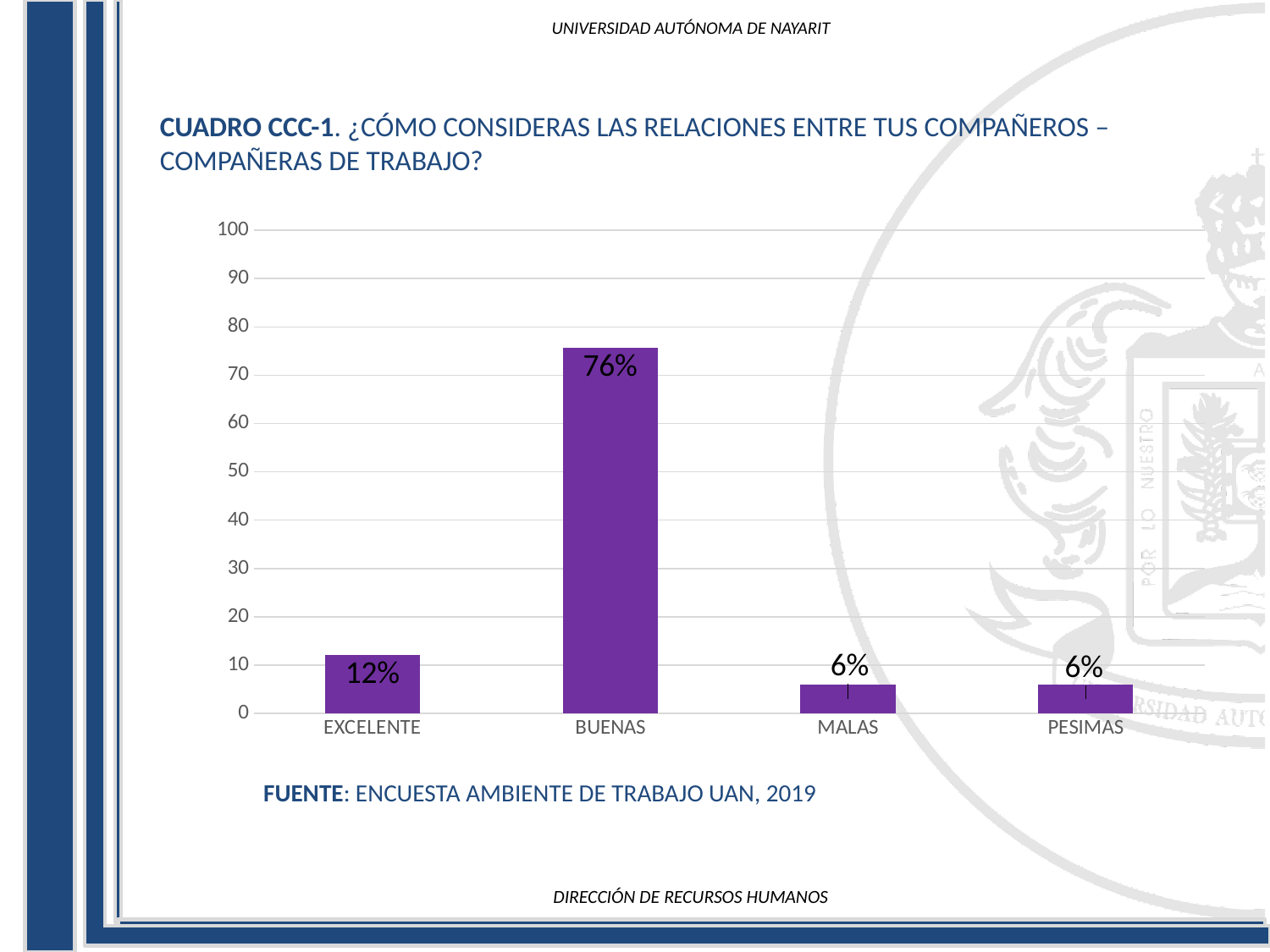
Is the value for BUENAS greater or less than 70? greater Is the value for PESIMAS greater or less than 10? less What source is cited below the chart? ENCUESTA AMBIENTE DE TRABAJO UAN, 2019 How many categories are shown on the x axis? 4 What is the value for MALAS? 6% What is the value for PESIMAS? 6% Which is larger, the value for EXCELENTE or the value for MALAS? EXCELENTE What is the value for EXCELENTE? 12% Which category has the highest value? BUENAS What is the value for BUENAS? 76% What is the difference between the values for BUENAS and EXCELENTE? 64% What kind of chart is shown on the slide? bar chart